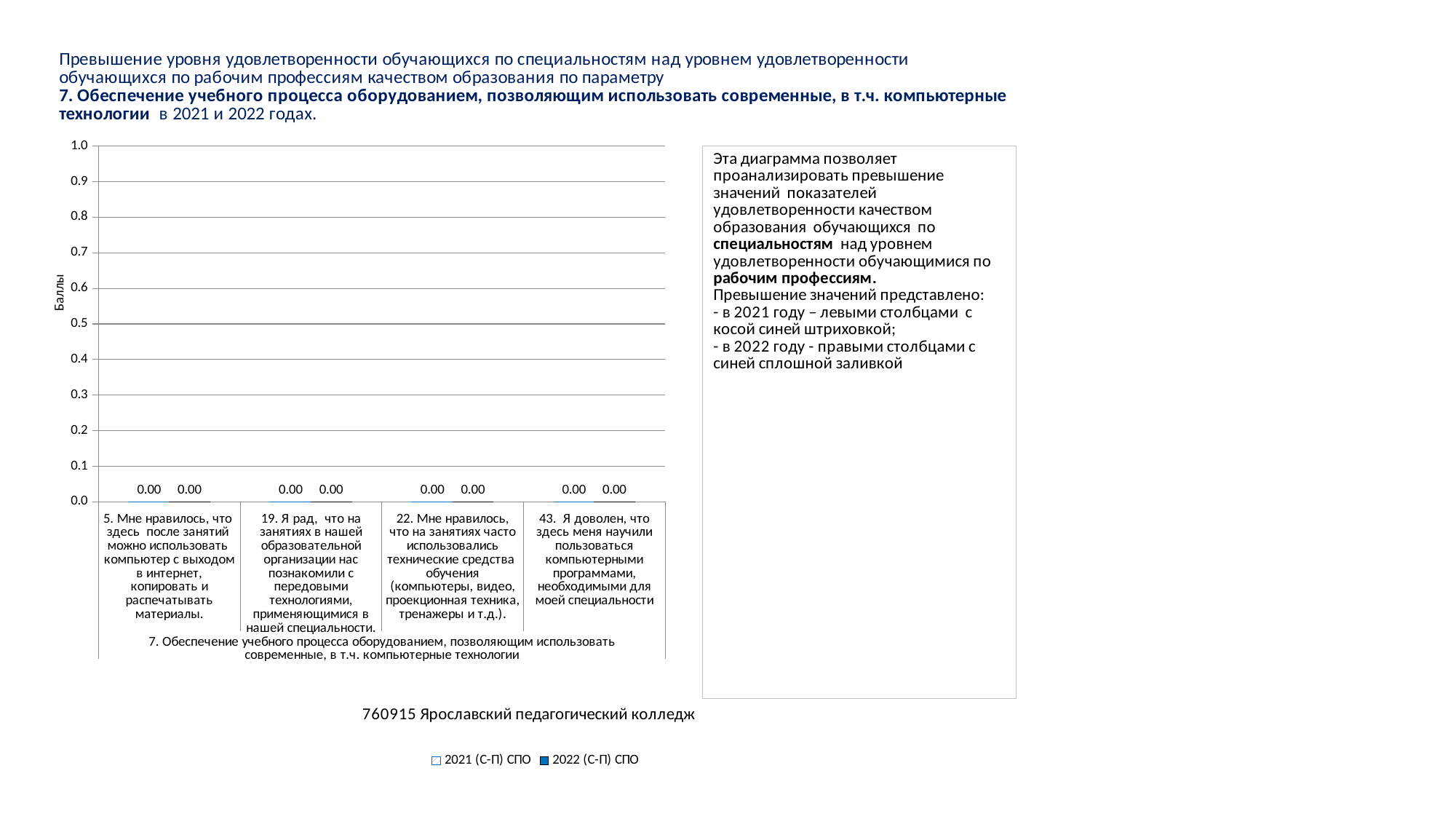
Is the value for the 2021 (С-П) СПО series for category 19 greater or less than 0.1? less What is the value for the 2021 (С-П) СПО series for category 22 ("Мне нравилось, что на занятиях часто использовались технические средства обучения...")? 0.00 How many categories are shown on the x axis of the chart? 4 What is the difference between the 2022 (С-П) СПО value and the 2021 (С-П) СПО value for category 5? 0.00 What is the value for the 2021 (С-П) СПО series for category 5 ("Мне нравилось, что здесь после занятий можно использовать компьютер с выходом в интернет...")? 0.00 How many series does the chart legend list? 2 What kind of chart is shown on the slide? bar chart Do the values of the 2022 (С-П) СПО series rise, fall, or stay the same across the categories? stay the same What is the value for the 2022 (С-П) СПО series for category 19 ("Я рад, что на занятиях в нашей образовательной организации нас познакомили с передовыми технологиями...")? 0.00 What is the label of the vertical axis of the chart? Баллы What is the value for the 2022 (С-П) СПО series for category 43 ("Я доволен, что здесь меня научили пользоваться компьютерными программами...")? 0.00 What are the two series names listed in the chart legend? 2021 (С-П) СПО and 2022 (С-П) СПО